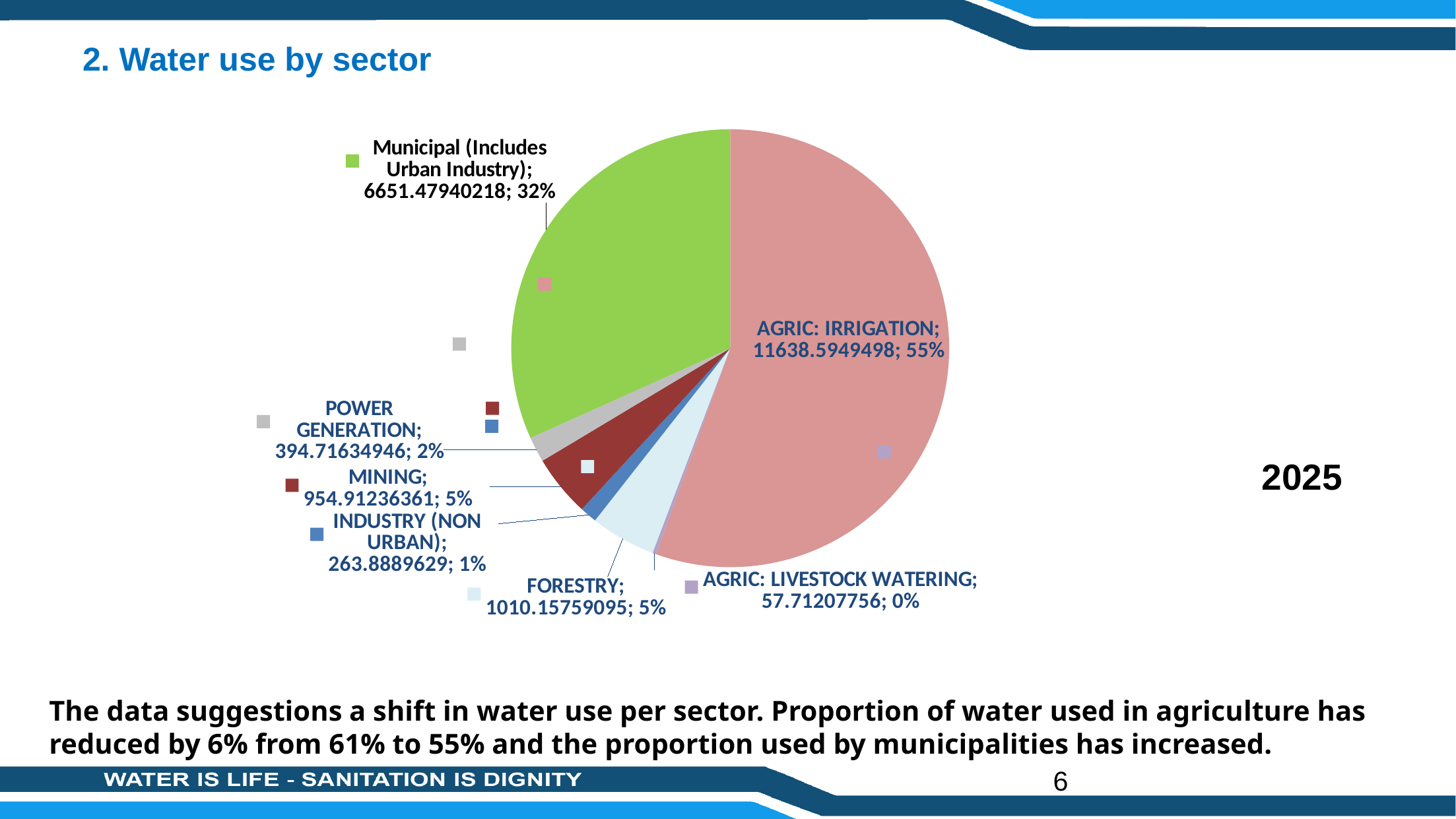
Which year is labelled next to the pie chart? 2025 What value is shown for INDUSTRY (NON URBAN)? 263.8889629 What share of the pie does FORESTRY account for? 5% What share of the pie does Municipal (Includes Urban Industry) account for? 32% What value is shown for AGRIC: IRRIGATION? 11638.5949498 How many sectors (slices) does the pie chart show? 7 Which sector has the smallest slice of the pie chart? AGRIC: LIVESTOCK WATERING What value is shown for MINING? 954.91236361 What is the difference between the value for Municipal (Includes Urban Industry) and the value for POWER GENERATION? 6256.76305272 What kind of chart is shown on the slide? pie chart Which is larger, the value for FORESTRY or the value for MINING? FORESTRY Which sector has the largest slice of the pie chart? AGRIC: IRRIGATION